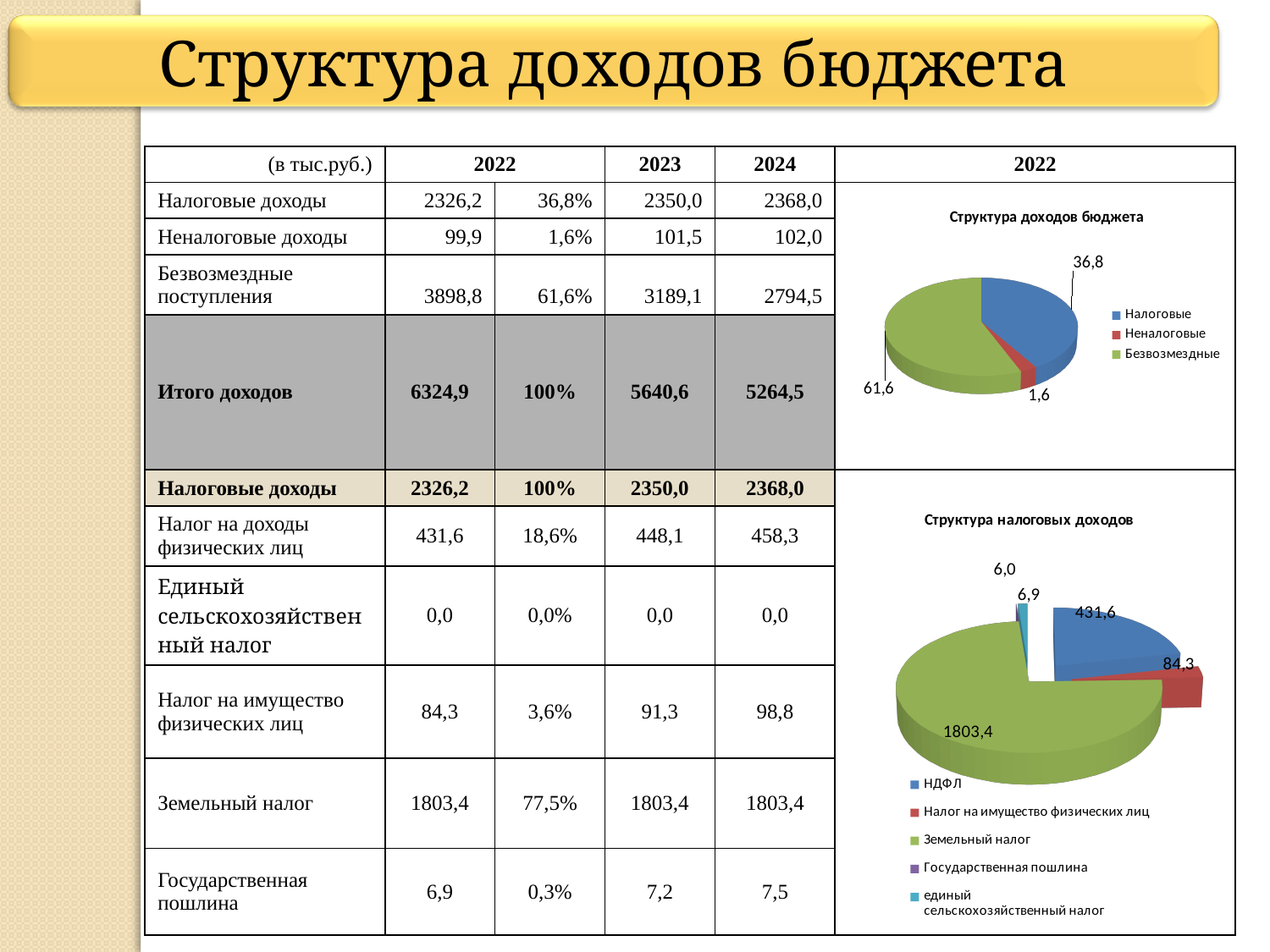
How many categories does the legend of the chart "Структура налоговых доходов" list? 5 What type of chart is the chart titled "Структура доходов бюджета"? Pie chart In the chart "Структура доходов бюджета", what value is shown for Налоговые? 36,8 In the chart "Структура доходов бюджета", which category has the smallest slice? Неналоговые In the chart "Структура налоговых доходов", what value is shown for НДФЛ? 431,6 In the chart "Структура доходов бюджета", what value is shown for Неналоговые? 1,6 How many categories does the legend of the chart "Структура доходов бюджета" list? 3 In the chart "Структура налоговых доходов", what is the difference between the values for Земельный налог and НДФЛ? 1371,8 In the chart "Структура налоговых доходов", which category has the largest slice? Земельный налог In the chart "Структура налоговых доходов", what value is shown for Земельный налог? 1803,4 In the chart "Структура доходов бюджета", what value is shown for Безвозмездные? 61,6 In the chart "Структура доходов бюджета", which category has the largest slice? Безвозмездные